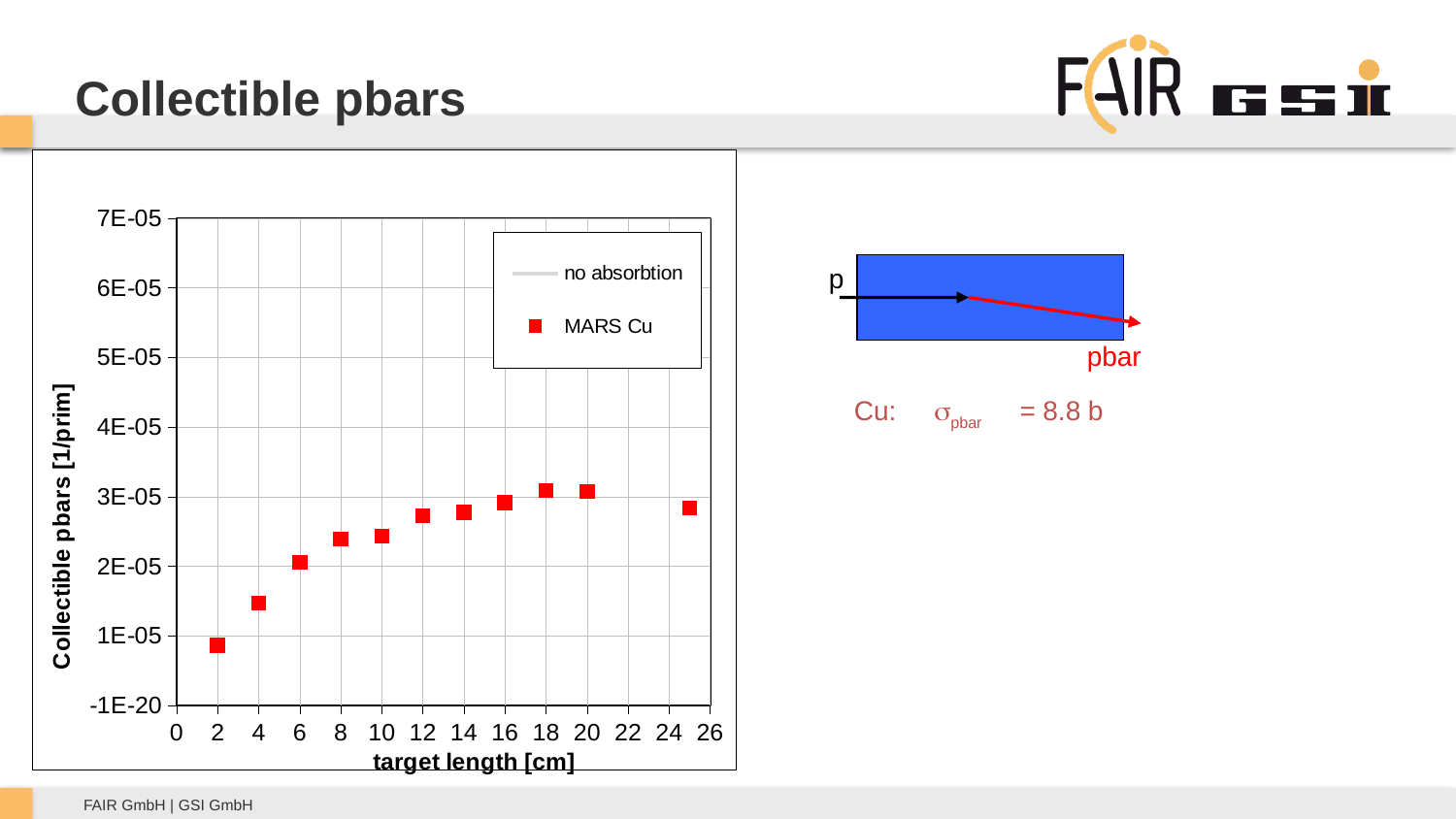
What is the label of the x axis of the chart? target length [cm] Which has the larger MARS Cu value: a target length of 4 cm or 25 cm? 25 cm How many entries does the chart legend list? 2 Is the MARS Cu value at a target length of 25 cm greater or less than 3E-05? less Is the MARS Cu value at a target length of 8 cm greater or less than 2E-05? greater Which has the larger MARS Cu value: a target length of 12 cm or 20 cm? 20 cm Do the MARS Cu values rise or fall as the target length increases from 2 cm to 18 cm? rise What kind of chart is shown on the slide? scatter plot At which target length is the MARS Cu value lowest? 2 cm Is the MARS Cu value at a target length of 2 cm greater or less than 1E-05? less How many MARS Cu data points are plotted on the chart? 11